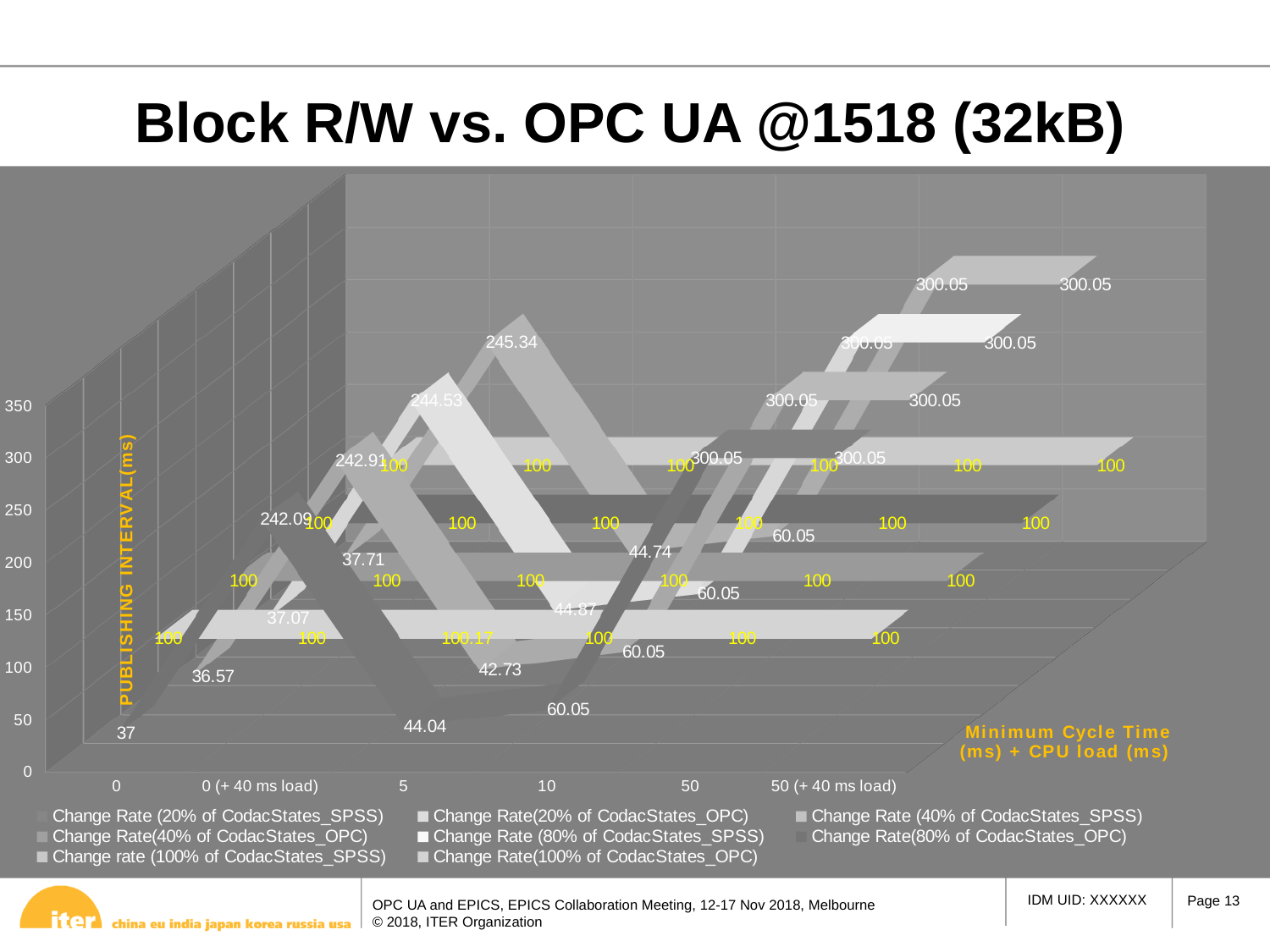
How many series does the chart legend list? 8 What is the title of the chart on the slide? Block R/W vs. OPC UA @1518 (32kB) What is the smallest data label value printed on the chart? 36.57 Is the largest data label value on the chart greater or less than 250? greater What is the last category label on the x axis of the chart? 50 (+ 40 ms load) How many categories are shown along the x axis of the chart? 6 What is the label of the vertical axis of the chart? PUBLISHING INTERVAL(ms) What is the highest tick value shown on the vertical axis? 350 What is the difference between the largest data label (300.05) and the smallest data label (36.57) on the chart? 263.48 What is the first category label on the x axis of the chart? 0 What is the largest data label value printed on the chart? 300.05 Which is larger among the data labels on the chart: 245.34 or 244.53? 245.34